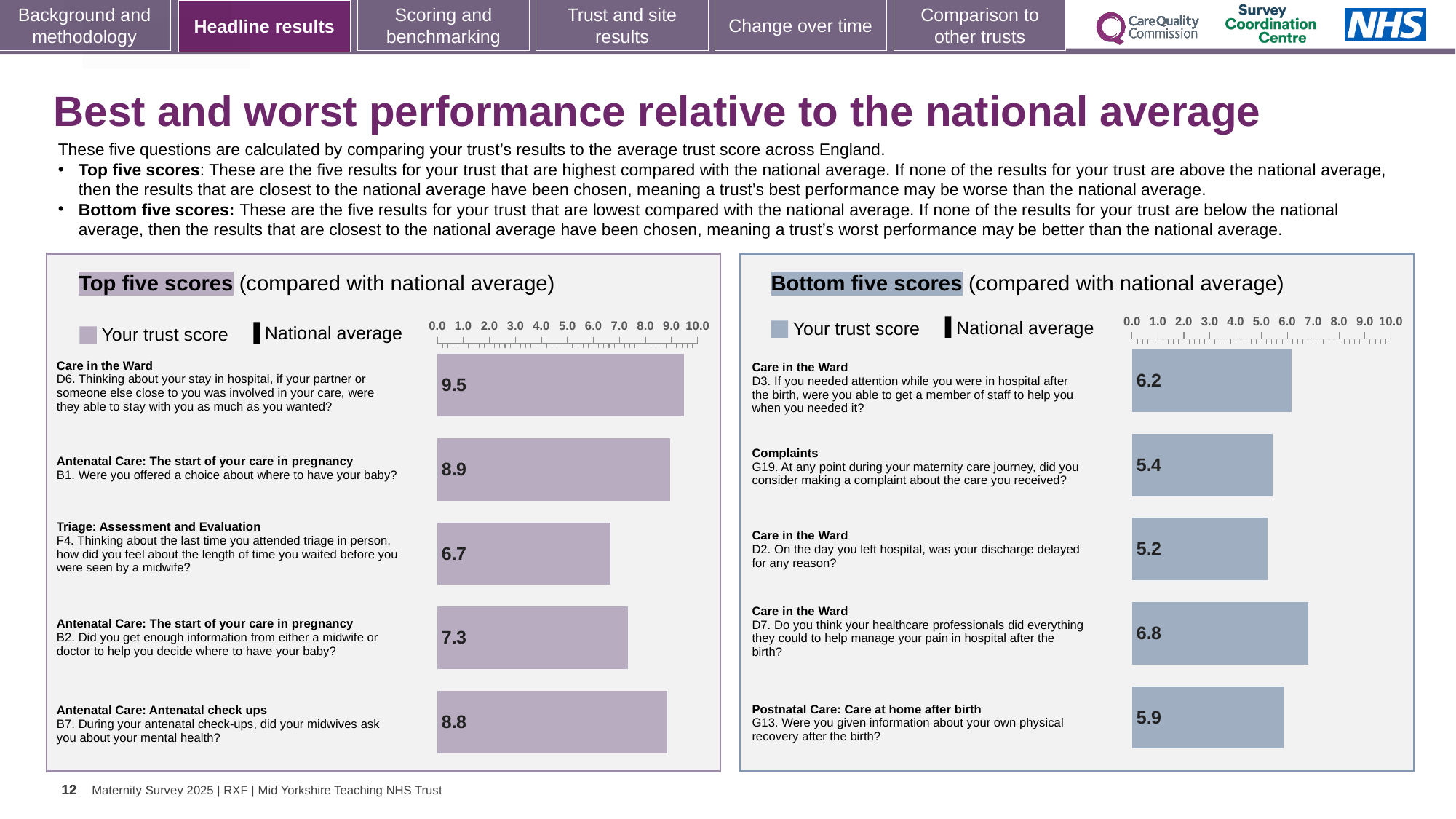
In the Top five scores chart, what is the trust score for B7 (midwives asking about your mental health during antenatal check-ups)? 8.8 In the Bottom five scores chart, what is the trust score for G19 (considering making a complaint)? 5.4 In the Bottom five scores chart, what is the difference between the trust scores for D7 and D2? 1.6 In the Bottom five scores chart, which question has the lowest trust score? D2 (Care in the Ward), 5.2 In the Top five scores chart, what is the difference between the trust scores for D6 and F4? 2.8 What type of chart is used for the Bottom five scores? Bar chart In the Top five scores chart, which question has the highest trust score? D6 (Care in the Ward), 9.5 In the Top five scores chart, what is the trust score for D6 (partner or someone close able to stay with you as much as you wanted)? 9.5 In the Top five scores chart, which question has the lowest trust score? F4 (Triage: Assessment and Evaluation), 6.7 In the Bottom five scores chart, which has the larger trust score: D3 or G13? D3 (6.2) In the Bottom five scores chart, which question has the highest trust score? D7 (Care in the Ward), 6.8 How many bars are shown in the Top five scores chart? 5